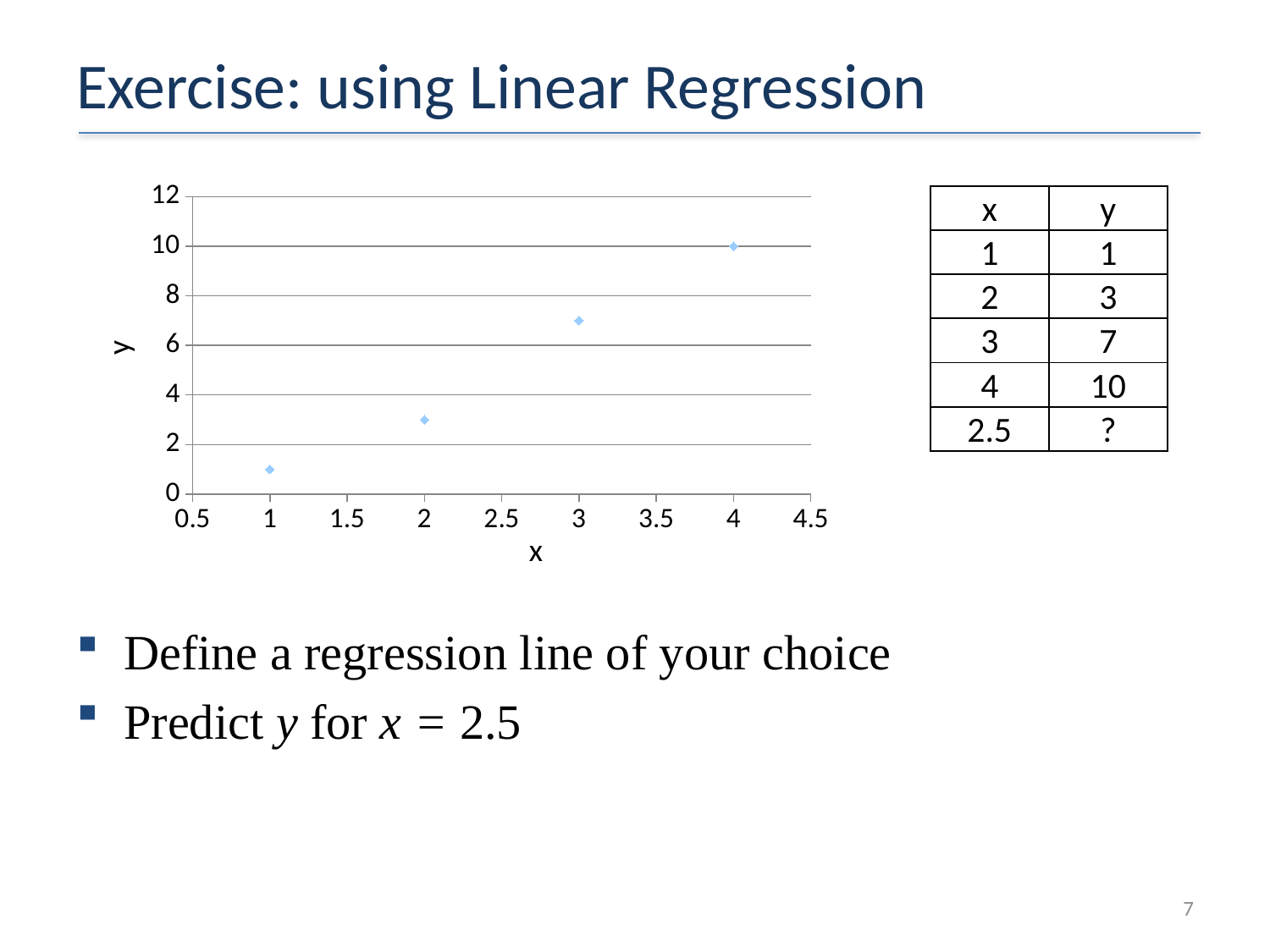
How many data points are plotted in the chart? 4 What is the y value of the point plotted at x = 4? 10 At which x value does the plotted point have the lowest y value? 1 What is the y value of the point plotted at x = 1? 1 At which x value does the plotted point have the highest y value? 4 Do the y values rise or fall as x increases along the x axis? rise What kind of chart is shown on the slide? scatter chart Which point has a larger y value, the one at x = 2 or the one at x = 3? x = 3 What is the label on the vertical axis of the chart? y What is the y value of the point plotted at x = 3? 7 What is the difference between the y value at x = 4 and the y value at x = 1? 9 Is the y value of the point at x = 3 greater or less than 6? greater